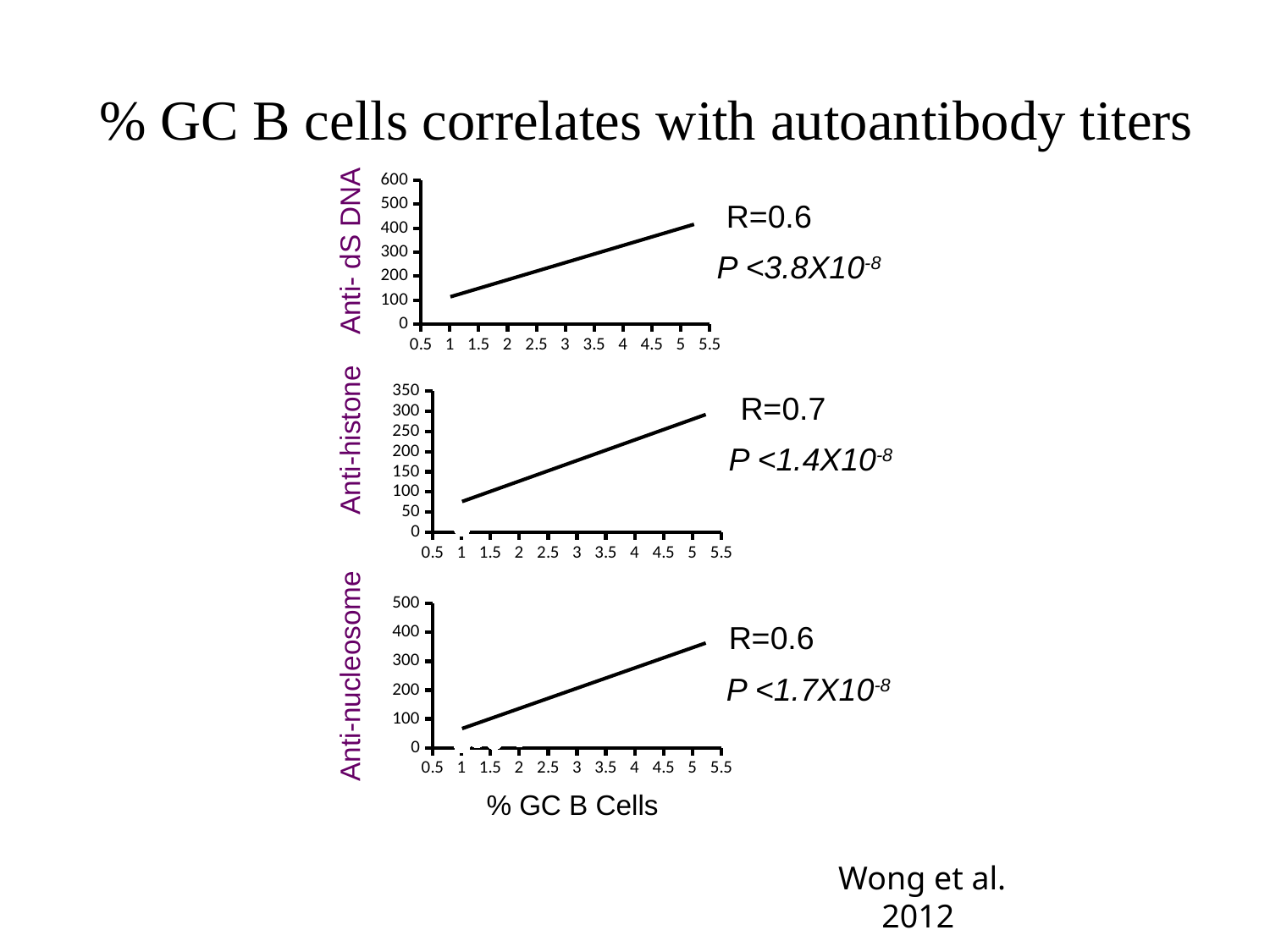
How many charts are shown on the slide? 3 In the top chart (Anti- dS DNA), does the line rise or fall as % GC B Cells increases? rise In the top chart (Anti- dS DNA), is the value at 3 % GC B Cells greater or less than 200? greater What is the highest value shown on the y axis of the middle chart (Anti-histone)? 350 What R value is shown next to the middle chart (Anti-histone)? R=0.7 In the middle chart (Anti-histone), does the line rise or fall along the x axis? rise In the middle chart (Anti-histone), is the value at 5 % GC B Cells greater or less than 200? greater In the bottom chart (Anti-nucleosome), does the line rise or fall along the x axis? rise What kind of chart is the top chart (Anti- dS DNA)? line chart In the bottom chart (Anti-nucleosome), is the value at 1 % GC B Cells greater or less than 100? less